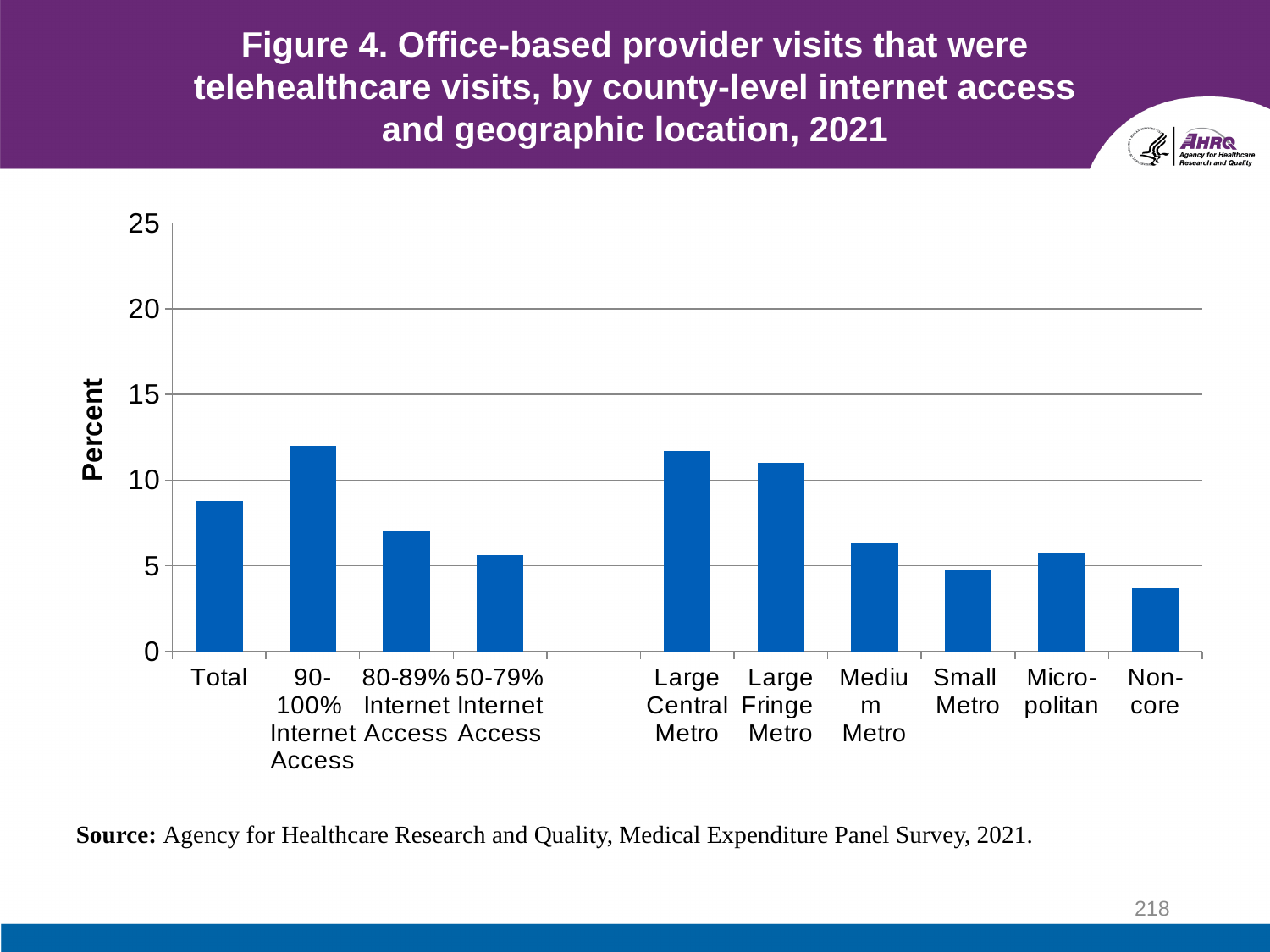
Is the value for Large Central Metro greater or less than 10? greater Which is larger, the value for Large Central Metro or the value for Medium Metro? Large Central Metro Which category has the lowest value? Non-core Is the value for 80-89% Internet Access greater or less than 10? less Which is larger, the value for 90-100% Internet Access or the value for 50-79% Internet Access? 90-100% Internet Access What kind of chart is shown on the slide? bar chart Is the value for 90-100% Internet Access greater or less than 10? greater What is the label on the vertical axis? Percent Which is larger, the value for Total or the value for 80-89% Internet Access? Total How many bars are plotted in the chart? 10